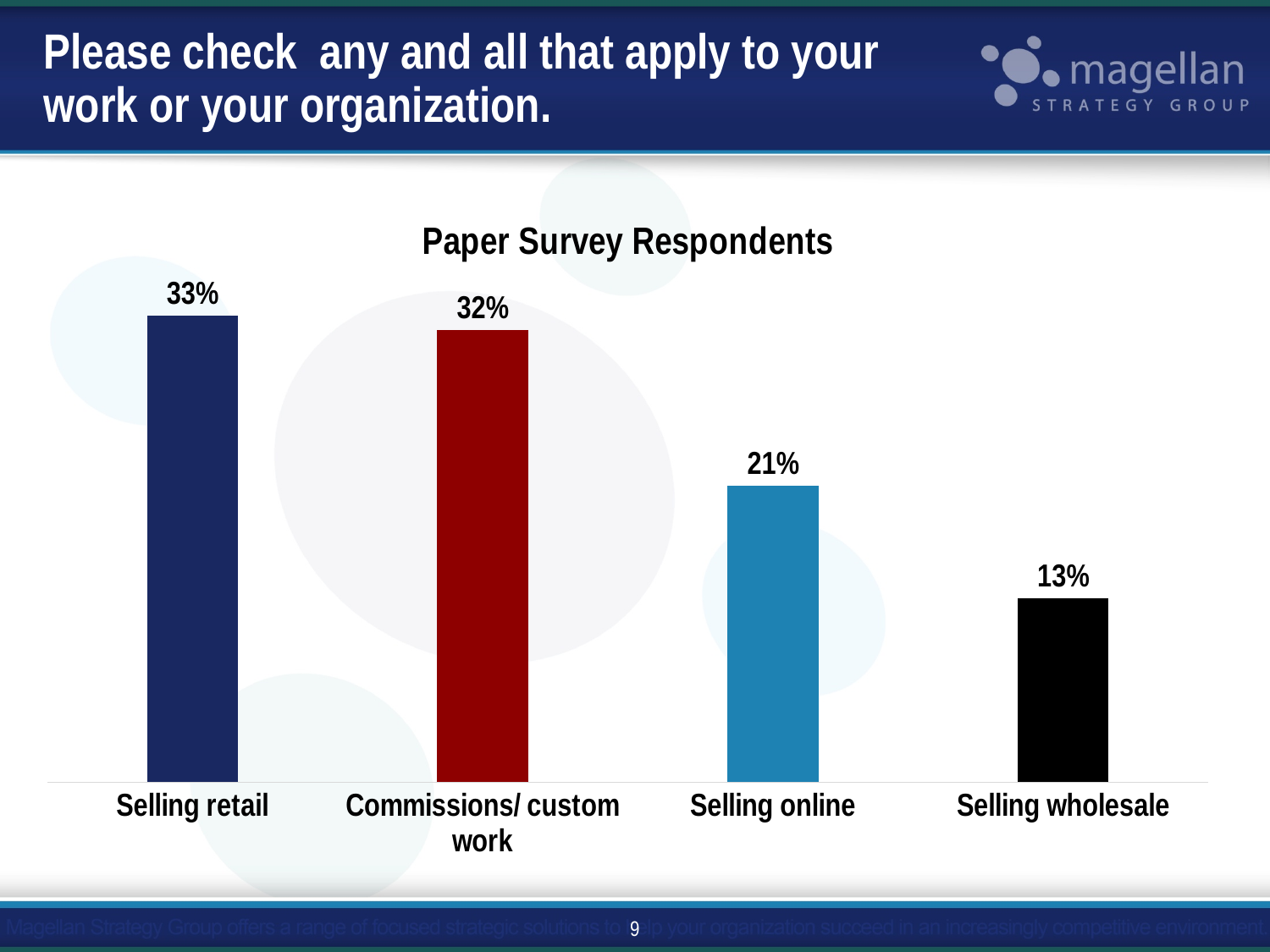
What kind of chart is shown on the slide? Bar chart What is the value for Selling wholesale? 13% Which is larger, the value for Selling online or the value for Selling wholesale? Selling online What percentage is shown for Selling online? 21% What is the value shown for Commissions/ custom work? 32% How many categories are shown in the chart? 4 What percentage of paper survey respondents selected Selling retail? 33% Which category has the lowest value? Selling wholesale What is the difference in percentage points between Selling online and Selling wholesale? 8 What is the difference in percentage points between Selling retail and Selling wholesale? 20 What is the title of the chart? Paper Survey Respondents Which category has the highest value? Selling retail